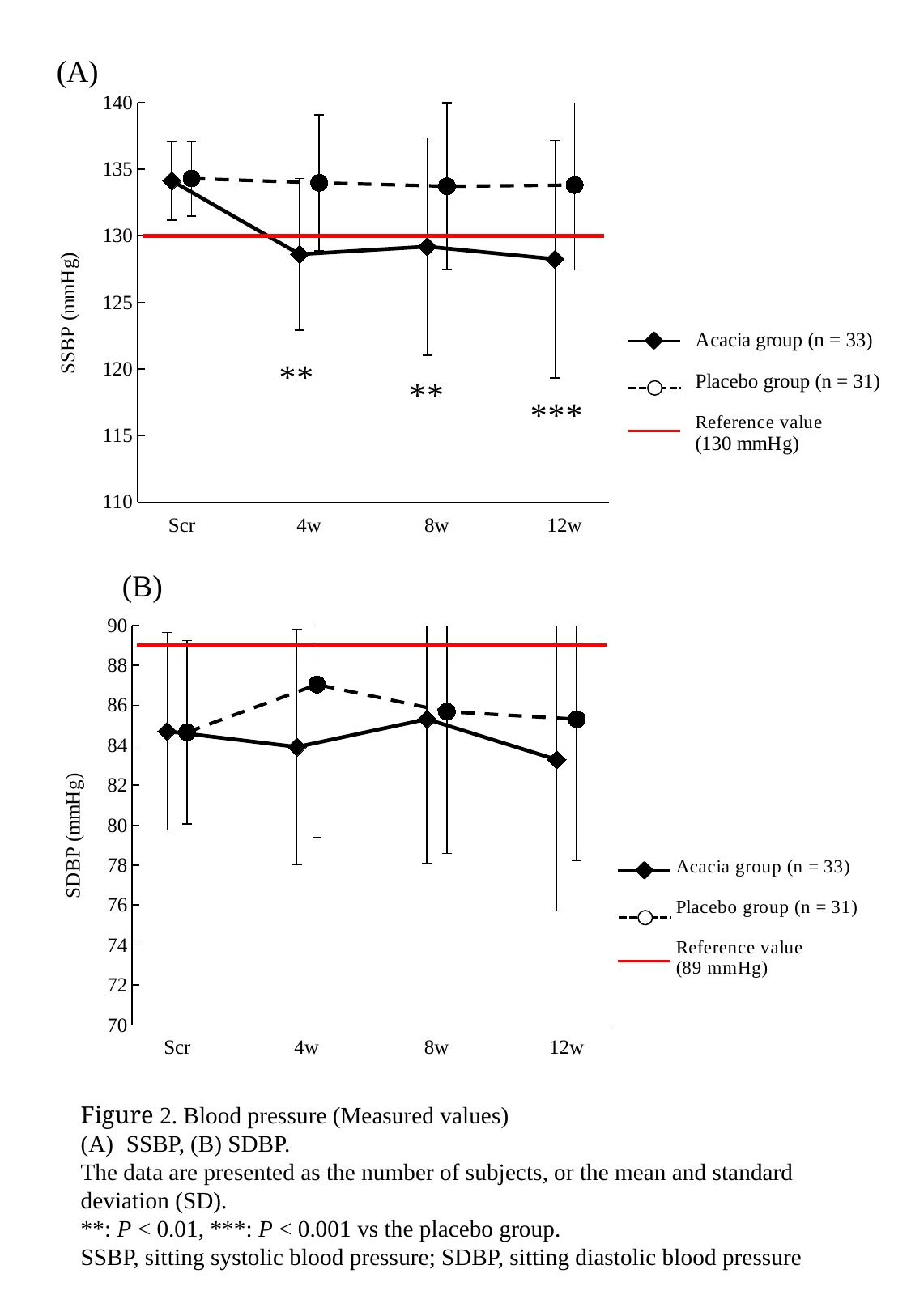
In chart (A) SSBP, how many time points are shown on the x axis? 4 In chart (A) SSBP, which group has the higher value at 12w, Acacia or Placebo? Placebo group In chart (A) SSBP, is the value for the Placebo group at 4w greater or less than 130? greater In chart (B) SDBP, which group has the higher value at 4w, Acacia or Placebo? Placebo group In chart (B) SDBP, is the value for the Acacia group at 12w greater or less than 85? less In chart (A) SSBP, does the Acacia group value rise or fall from Scr to 12w? fall In chart (A) SSBP, how many entries does the legend list? 3 In chart (A) SSBP, at which time point is the Acacia group value highest? Scr In chart (B) SDBP, what reference value does the legend give for the red line? 89 mmHg In chart (A) SSBP, what kind of chart is shown? line chart In chart (B) SDBP, at which time point is the Placebo group value highest? 4w In chart (A) SSBP, is the value for the Acacia group at 12w greater or less than 130? less